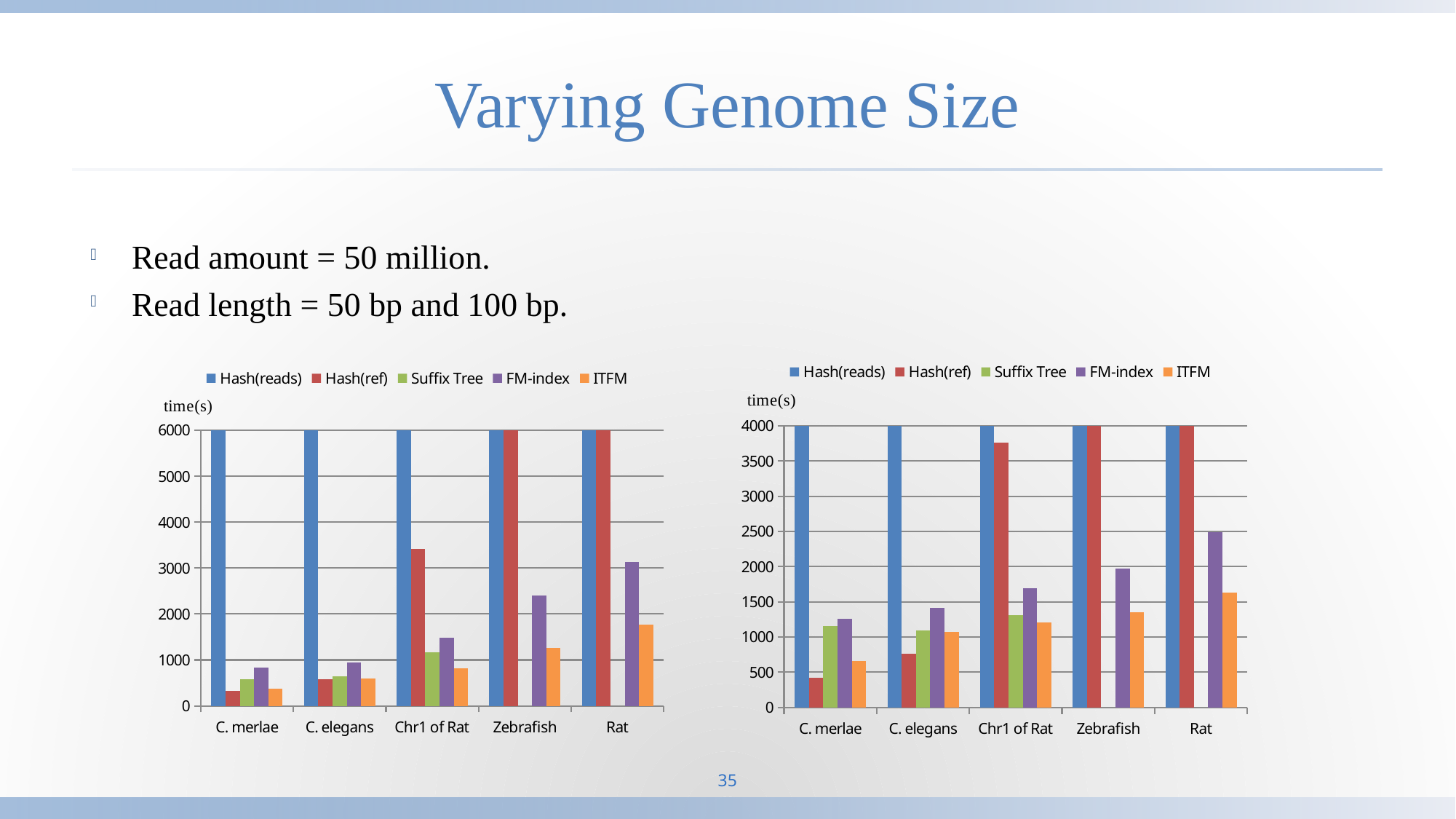
In the left chart, for Chr1 of Rat, which is larger: Hash(ref) or ITFM? Hash(ref) In the left chart, do the ITFM values rise or fall from C. merlae to Rat? rise In the right chart, is the FM-index value for Rat greater or less than 2000? greater In the left chart, is the ITFM value for Zebrafish greater or less than 2000? less What kind of chart is the left chart? bar chart In the right chart, is the Hash(ref) value for Chr1 of Rat greater or less than 3500? greater In the right chart, how many categories are shown on the x axis? 5 In the left chart, how many series does the legend list? 5 In the right chart, which category has the highest FM-index value? Rat What is the label on the vertical axis of the right chart? time(s) In the right chart, for C. merlae, which is larger: Suffix Tree or ITFM? Suffix Tree